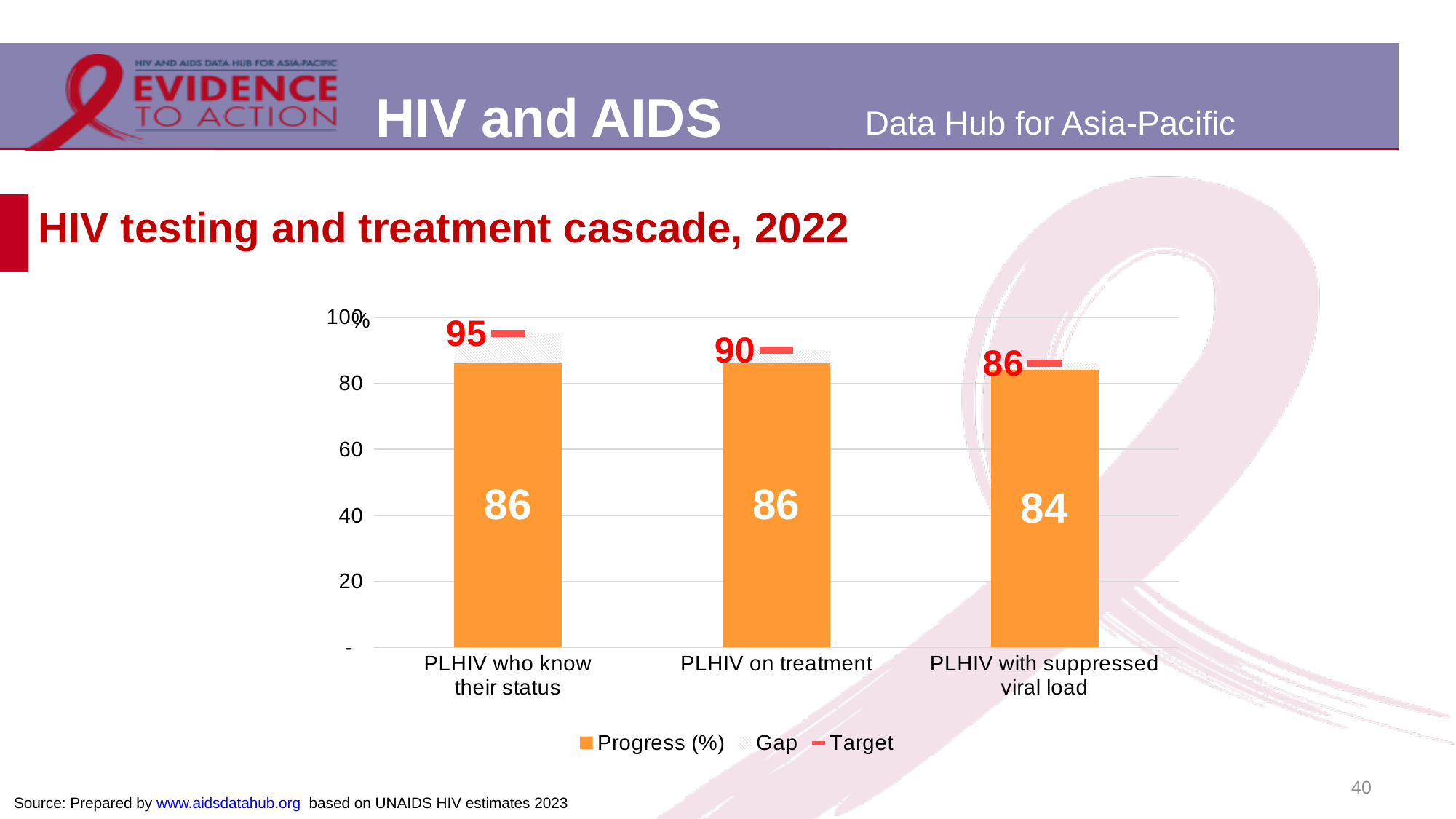
What is the Progress (%) value for PLHIV who know their status? 86 What is the Target value shown for PLHIV who know their status? 95 What is the difference between the Target and the Progress (%) value for PLHIV who know their status? 9 Is the Progress (%) value for PLHIV on treatment greater or less than its Target value? less What is the difference between the Target and the Progress (%) value for PLHIV on treatment? 4 How many series does the legend list? 3 How many categories are shown on the x axis? 3 Which category has the highest Target value? PLHIV who know their status What kind of chart is shown on the slide? bar chart What is the Progress (%) value for PLHIV with suppressed viral load? 84 What is the Target value shown for PLHIV on treatment? 90 Which category has the lowest Progress (%) value? PLHIV with suppressed viral load